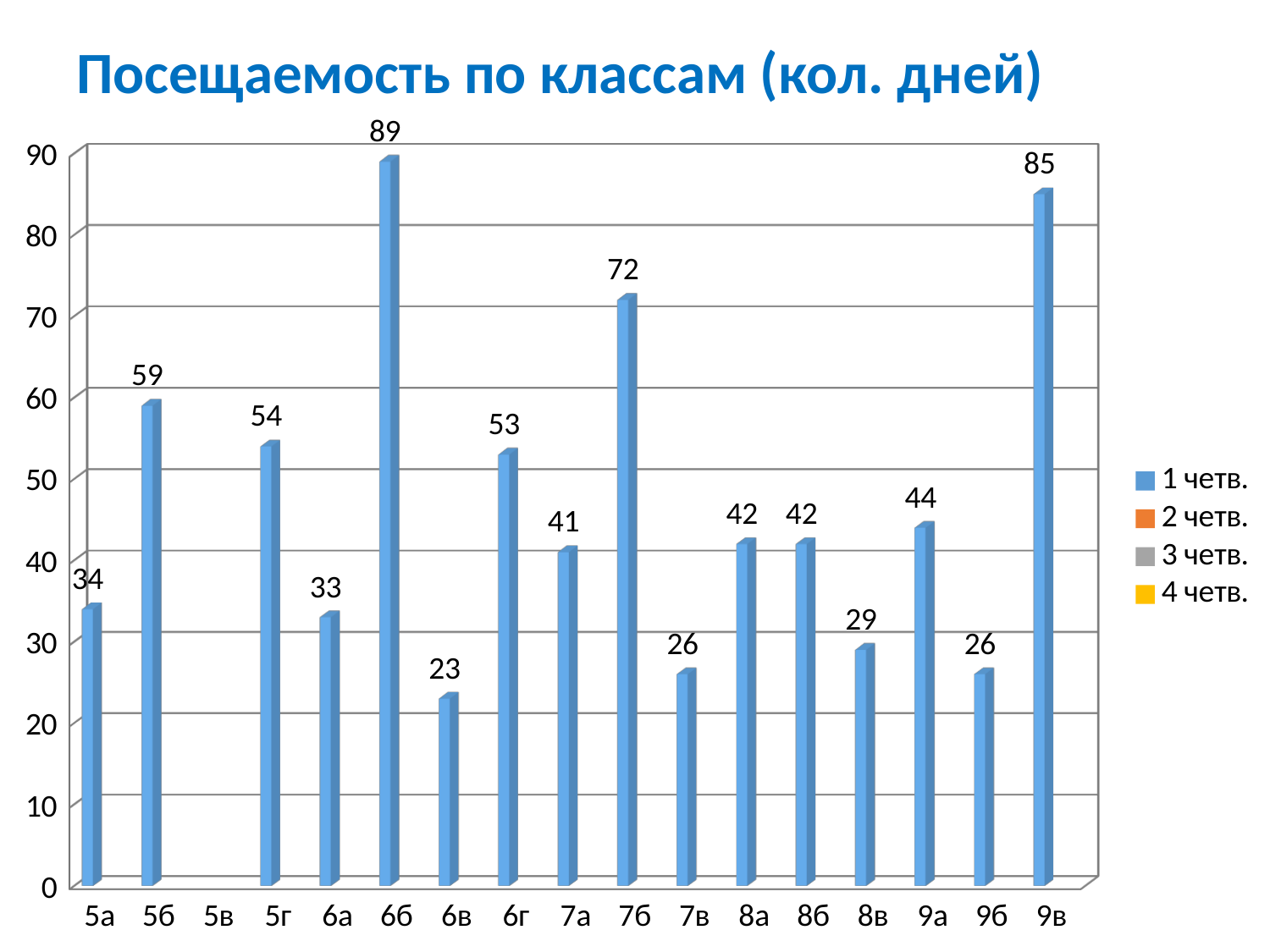
What is the value for class 6б in the 1 четв. series? 89 What is the value for class 7б? 72 Which class has the highest value? 6б Which class has the lowest non-zero value shown with a data label? 6в Which is larger, the value for 5б or the value for 5г? 5б How many class categories are shown on the x axis? 17 Which class has no bar plotted? 5в What is the title of the chart? Посещаемость по классам (кол. дней) What is the difference between the values for 9в and 9б? 59 What kind of chart is shown? bar chart What is the value for class 8в? 29 How many series does the legend list? 4